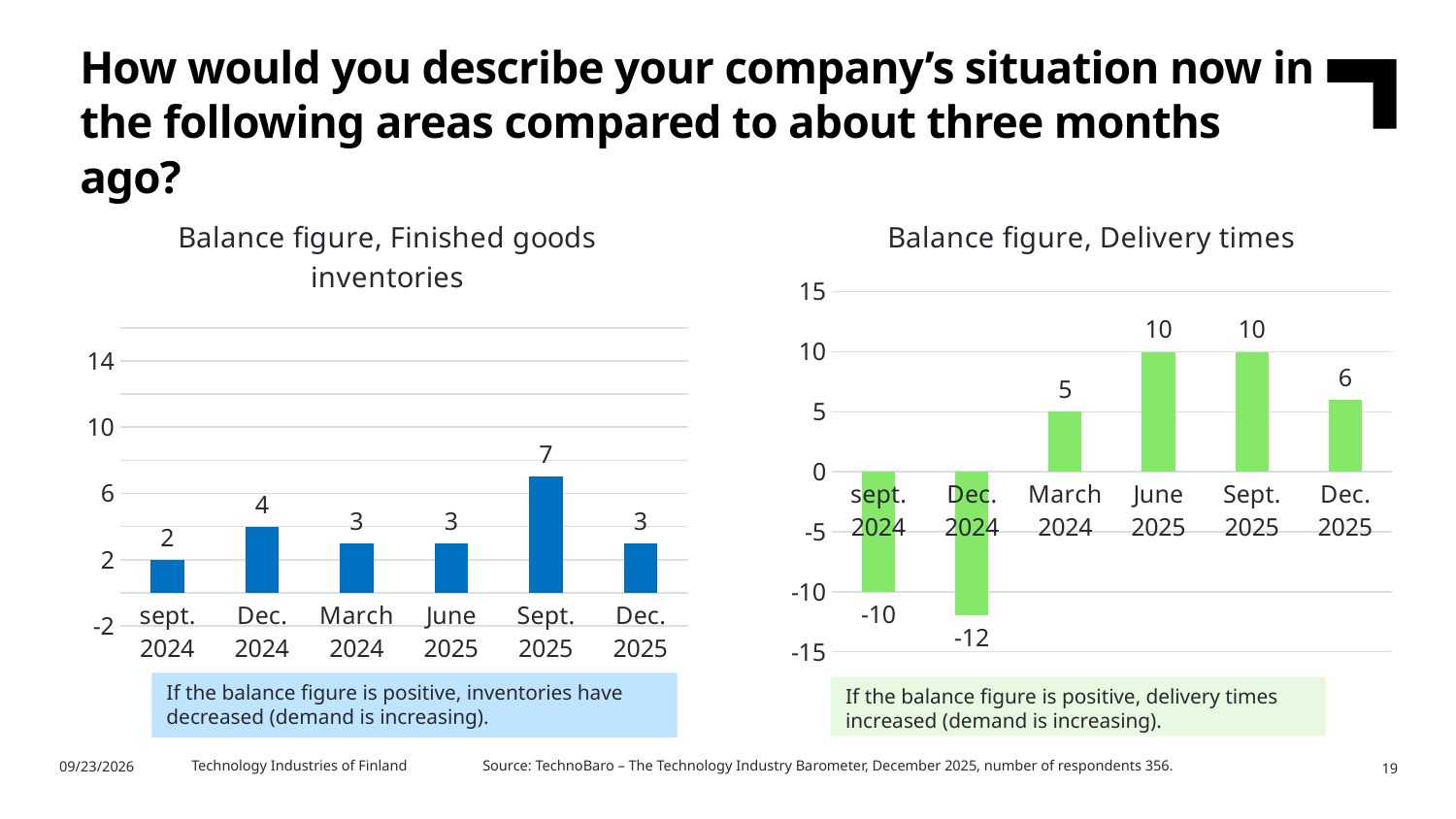
How many periods are shown in the 'Balance figure, Delivery times' chart? 6 In the 'Balance figure, Delivery times' chart, what is the difference between the values for June 2025 and March 2024? 5 In the 'Balance figure, Finished goods inventories' chart, which period has the lowest value? sept. 2024 In the 'Balance figure, Finished goods inventories' chart, what is the value for sept. 2024? 2 In the 'Balance figure, Delivery times' chart, what is the value for Dec. 2025? 6 In the 'Balance figure, Delivery times' chart, which is larger, the value for March 2024 or the value for Dec. 2025? Dec. 2025 In the 'Balance figure, Finished goods inventories' chart, what is the value for Sept. 2025? 7 In the 'Balance figure, Finished goods inventories' chart, which period has the highest value? Sept. 2025 In the 'Balance figure, Finished goods inventories' chart, what is the difference between the values for Sept. 2025 and Dec. 2025? 4 What kind of chart is the 'Balance figure, Finished goods inventories' chart? Bar chart In the 'Balance figure, Delivery times' chart, which period has the lowest value? Dec. 2024 In the 'Balance figure, Delivery times' chart, what is the value for Dec. 2024? -12